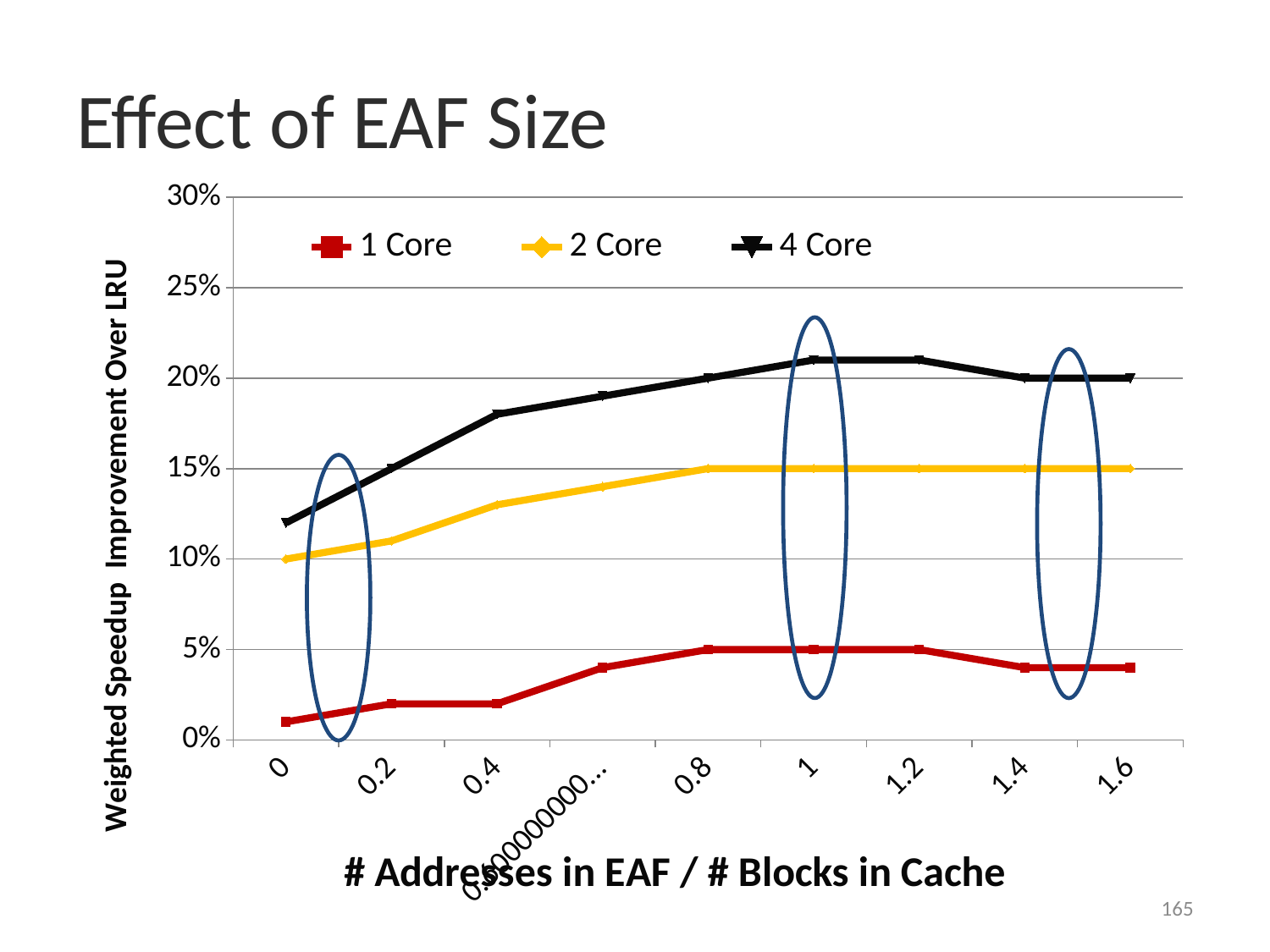
Which series has the lowest weighted speedup improvement across the chart? 1 Core What is the weighted speedup improvement for 2 Core at x = 0? 10% How many series does the legend list? 3 What is the weighted speedup improvement for 4 Core at x = 0.8? 20% What is the weighted speedup improvement for 1 Core at x = 0.8? 5% Which series has the highest weighted speedup improvement across the chart? 4 Core What kind of chart is shown on the slide? line chart What is the weighted speedup improvement for 2 Core at x = 1.6? 15% Which is larger at x = 0.4: the value for 2 Core or the value for 1 Core? 2 Core Is the value for 4 Core at x = 1 greater or less than 20%? greater Is the value for 1 Core at x = 0 greater or less than 5%? less Does the 4 Core series rise or fall from x = 0 to x = 0.8? rise